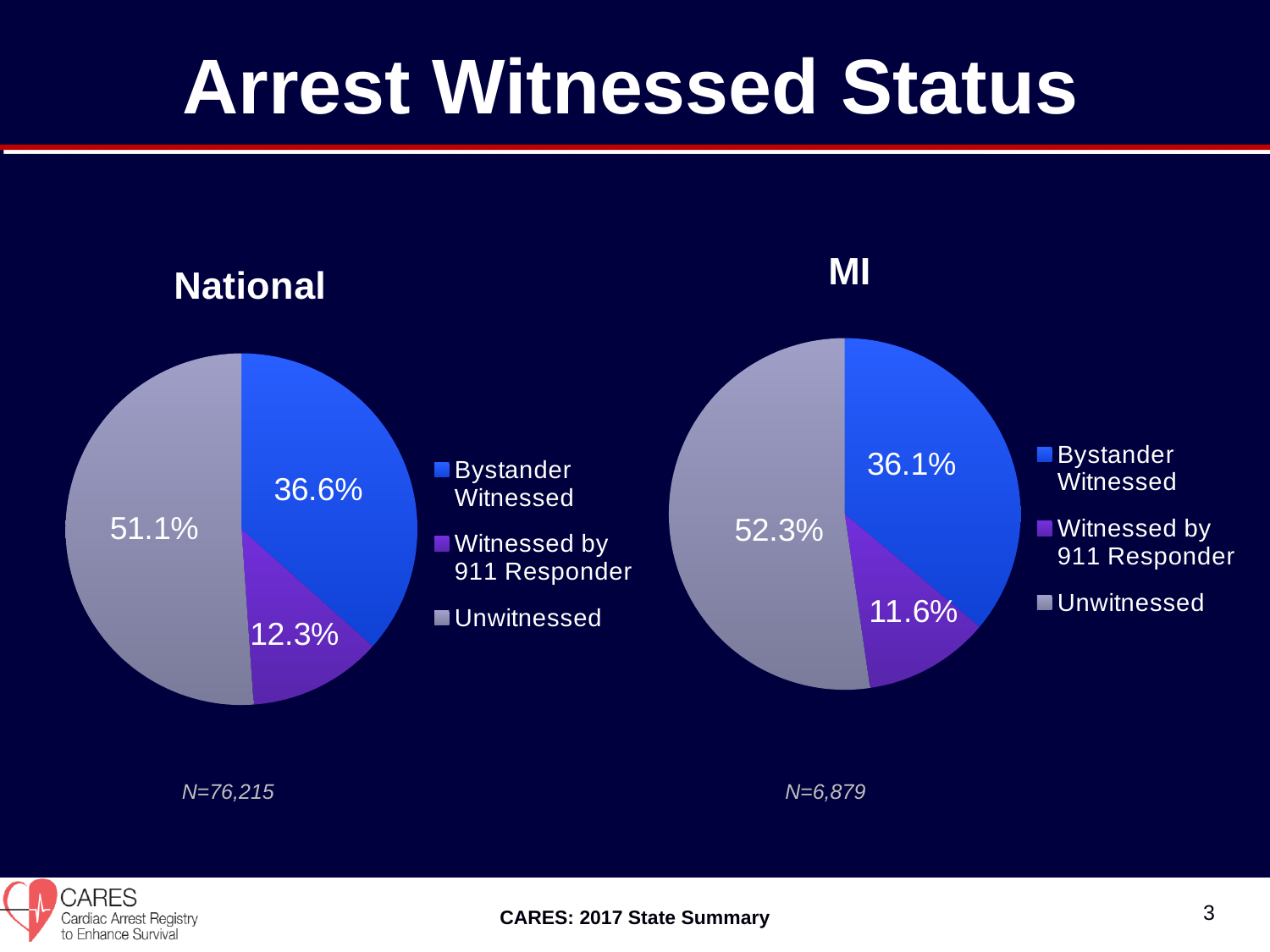
In the National chart, what percentage of arrests were Bystander Witnessed? 36.6% In the MI chart, what percentage of arrests were Witnessed by 911 Responder? 11.6% In the National chart, which category has the largest share? Unwitnessed In the National chart, what is the difference between the Unwitnessed and Bystander Witnessed shares? 14.5% In the MI chart, which category has the smallest share? Witnessed by 911 Responder What type of chart is used for the MI data? Pie chart How many categories does the National pie chart show? 3 What is the title of the slide containing the two charts? Arrest Witnessed Status Is the Bystander Witnessed share in the MI chart greater or less than the Bystander Witnessed share in the National chart? less What is the sample size (N) shown under the MI chart? N=6,879 In the MI chart, what percentage of arrests were Unwitnessed? 52.3% Which chart shows a larger Unwitnessed share, National or MI? MI